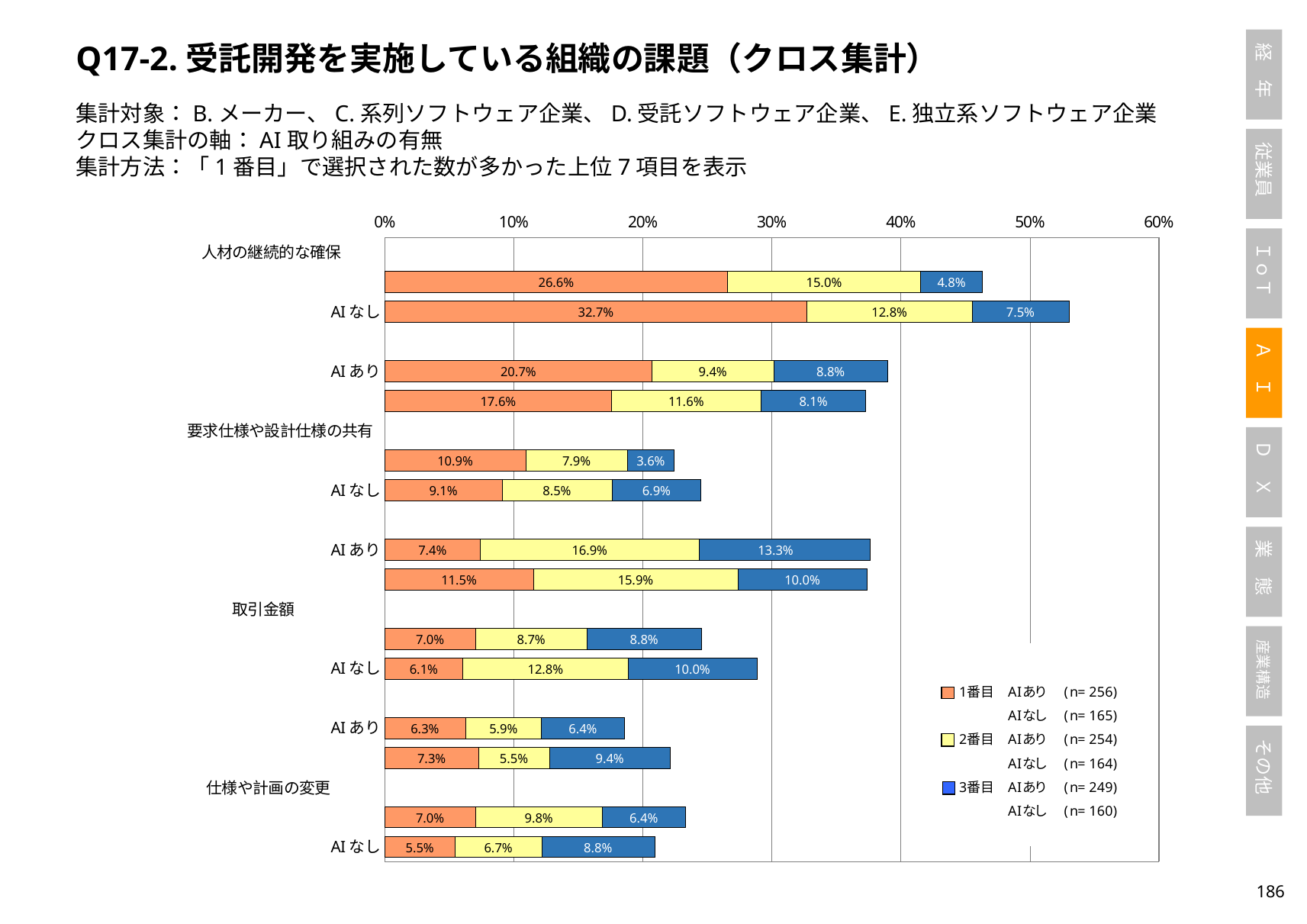
What kind of chart is shown on the slide? Stacked horizontal bar chart What is the total of the AI なし stacked bar under 人材の継続的な確保 (32.7% + 12.8% + 7.5%)? 53.0% Is the total length of the AI なし bar under 人材の継続的な確保 greater or less than 50%? greater According to the legend, what is the n for 1番目 AIあり? n= 256 What is the 1番目 value for the AI なし bar under 人材の継続的な確保? 32.7% What is the 2番目 value for the first (AI あり) bar under 人材の継続的な確保? 15.0% How many series does the legend list (1番目, 2番目, 3番目)? 3 How many stacked bars are plotted in the chart? 14 What is the 3番目 value for the AI なし bar under 人材の継続的な確保? 7.5% Which bar has the largest 1番目 value in the chart? AI なし under 人材の継続的な確保 (32.7%) What is the total of the AI あり stacked bar under 人材の継続的な確保 (26.6% + 15.0% + 4.8%)? 46.4% What is the difference between the 1番目 values of the AI なし bar (32.7%) and the AI あり bar (26.6%) under 人材の継続的な確保? 6.1 percentage points